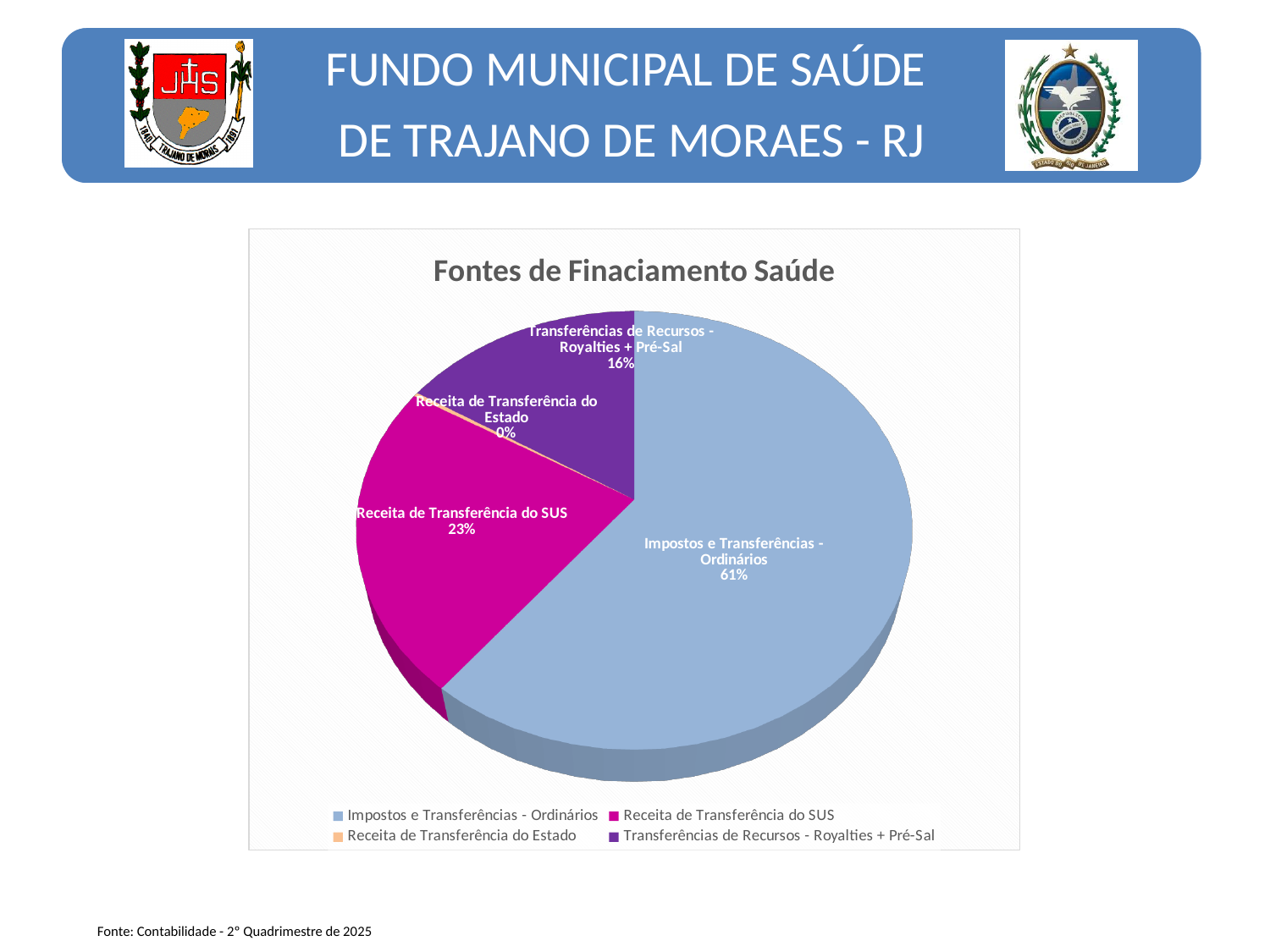
How many categories does the legend list? 4 What is the difference in percentage points between Impostos e Transferências - Ordinários and Receita de Transferência do SUS? 38 percentage points What type of chart is shown on the slide? Pie chart What share of the pie does Impostos e Transferências - Ordinários represent? 61% Which category has the largest share of the pie? Impostos e Transferências - Ordinários What share of the pie does Receita de Transferência do Estado represent? 0% What share of the pie does Receita de Transferência do SUS represent? 23% Which is larger: the share for Receita de Transferência do SUS or the share for Transferências de Recursos - Royalties + Pré-Sal? Receita de Transferência do SUS What is the title of the chart? Fontes de Finaciamento Saúde Which category has the smallest share of the pie? Receita de Transferência do Estado What colour is the slice for Receita de Transferência do SUS? Magenta